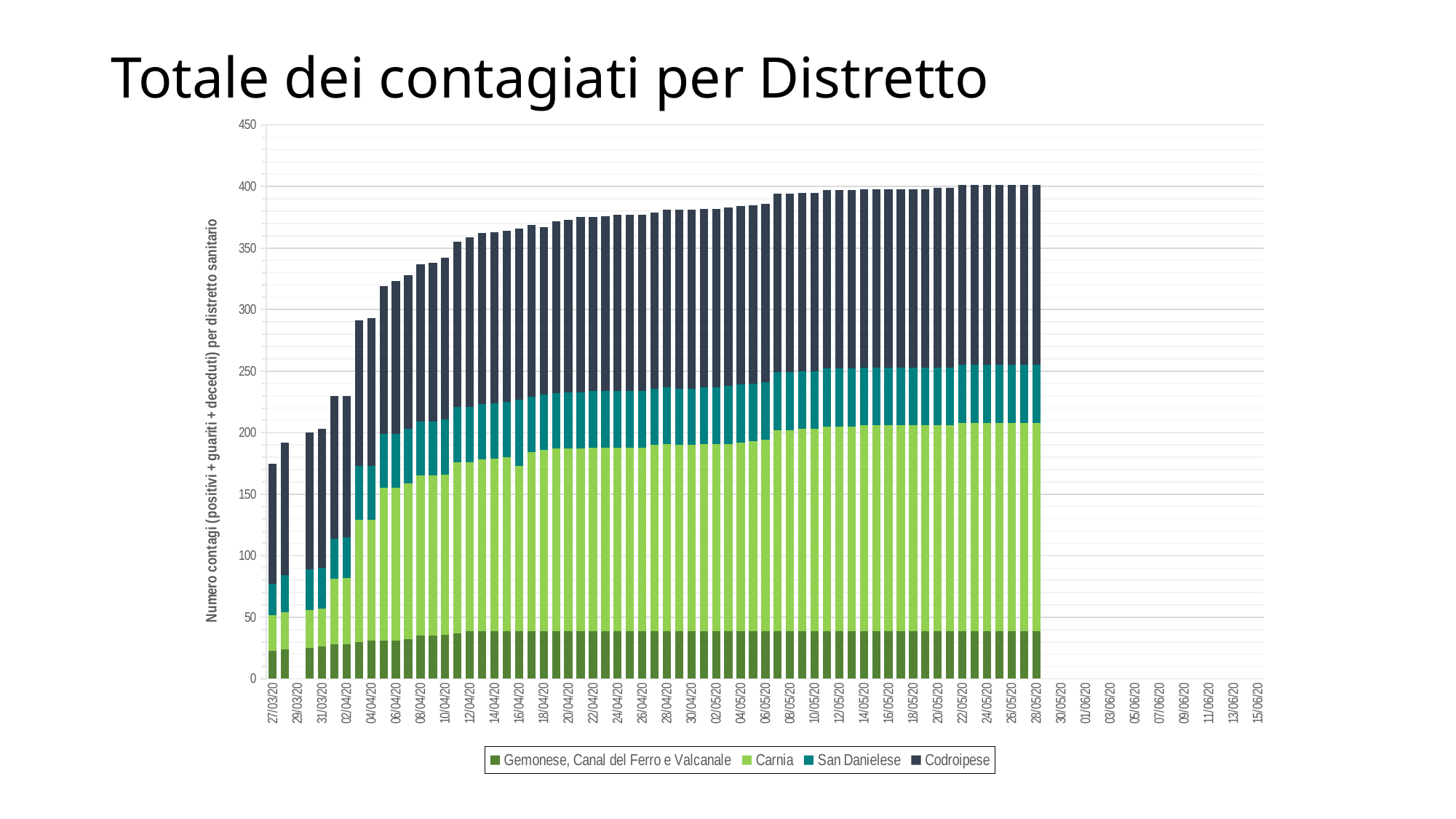
On 28/05/20, which series has the largest segment, Carnia or Codroipese? Carnia Is the total value for 27/03/20 greater or less than 200? less Is the total value for 28/05/20 greater or less than 350? greater What is the title of the chart? Totale dei contagiati per Distretto On 28/05/20, which series has the smallest segment? Gemonese, Canal del Ferro e Valcanale How many series does the legend list? 4 Do the total values rise or fall along the x axis from 27/03/20 to 28/05/20? rise What kind of chart is shown on the slide? bar chart Which date has the lowest total value? 27/03/20 Is the Gemonese, Canal del Ferro e Valcanale segment for 28/05/20 greater or less than 50? less Which series are listed in the legend? Gemonese, Canal del Ferro e Valcanale; Carnia; San Danielese; Codroipese